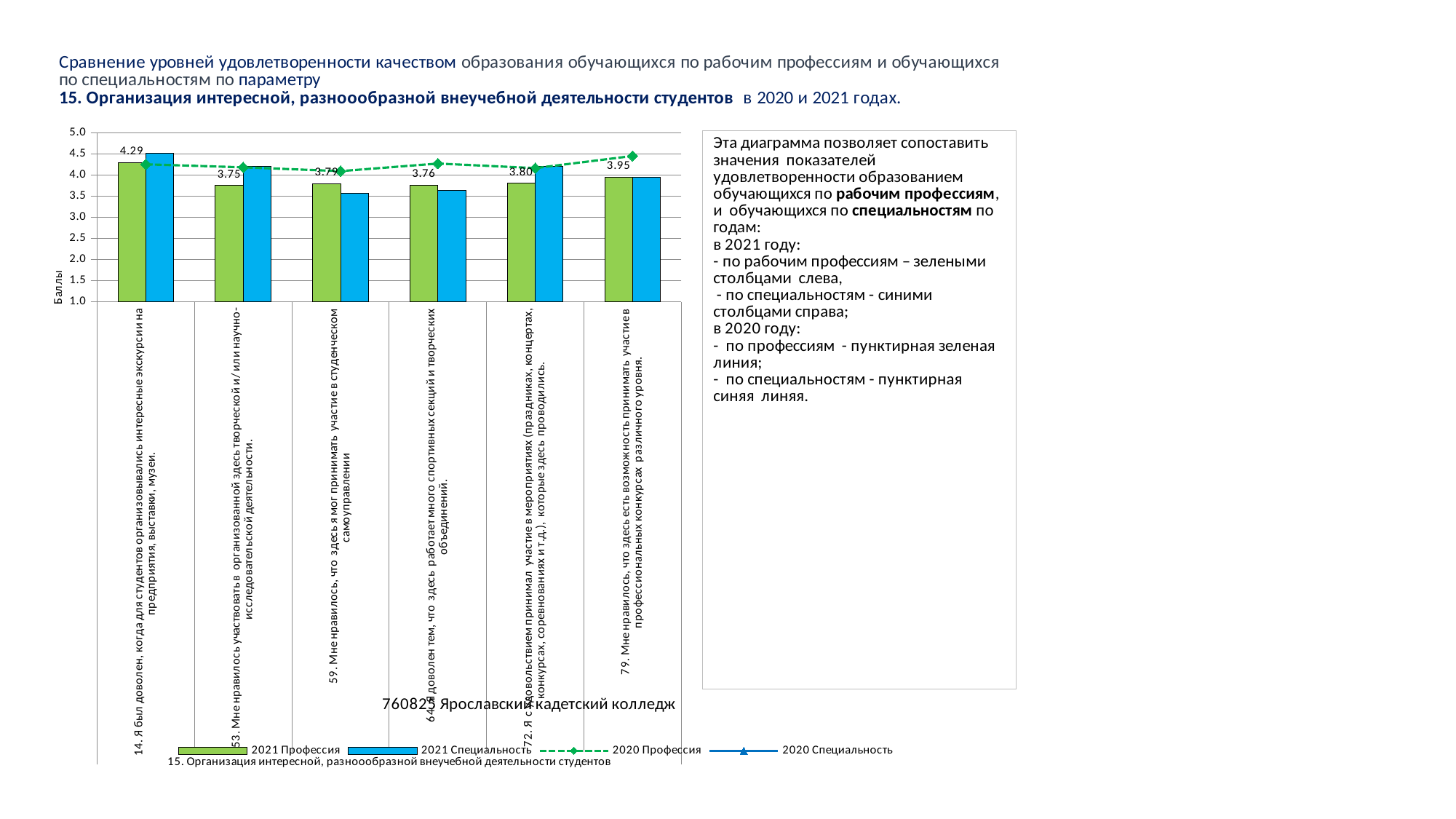
What is the label of the vertical axis of the chart? Баллы What is the difference between the 2021 Профессия values for statement 79 and statement 72? 0.15 What is the 2021 Профессия value for statement 79 (Мне нравилось, что здесь есть возможность принимать участие в профессиональных конкурсах...)? 3.95 For statement 59, which is larger: the 2021 Профессия bar or the 2021 Специальность bar? 2021 Профессия Which statement number has the highest 2021 Профессия value? 14 What is the 2021 Профессия value for statement 14 (Я был доволен, когда для студентов организовывались интересные экскурсии...)? 4.29 What is the 2021 Профессия value for statement 53 (Мне нравилось участвовать в организованной здесь творческой и/или научно-исследовательской деятельности)? 3.75 How many series does the chart legend list? 4 What is the difference between the 2021 Профессия values for statement 14 and statement 53? 0.54 Is the 2021 Специальность value for statement 59 greater or less than 4.0? less How many statements (categories) are shown on the x axis of the chart? 6 For statement 14, which is larger: the 2021 Профессия bar or the 2021 Специальность bar? 2021 Специальность